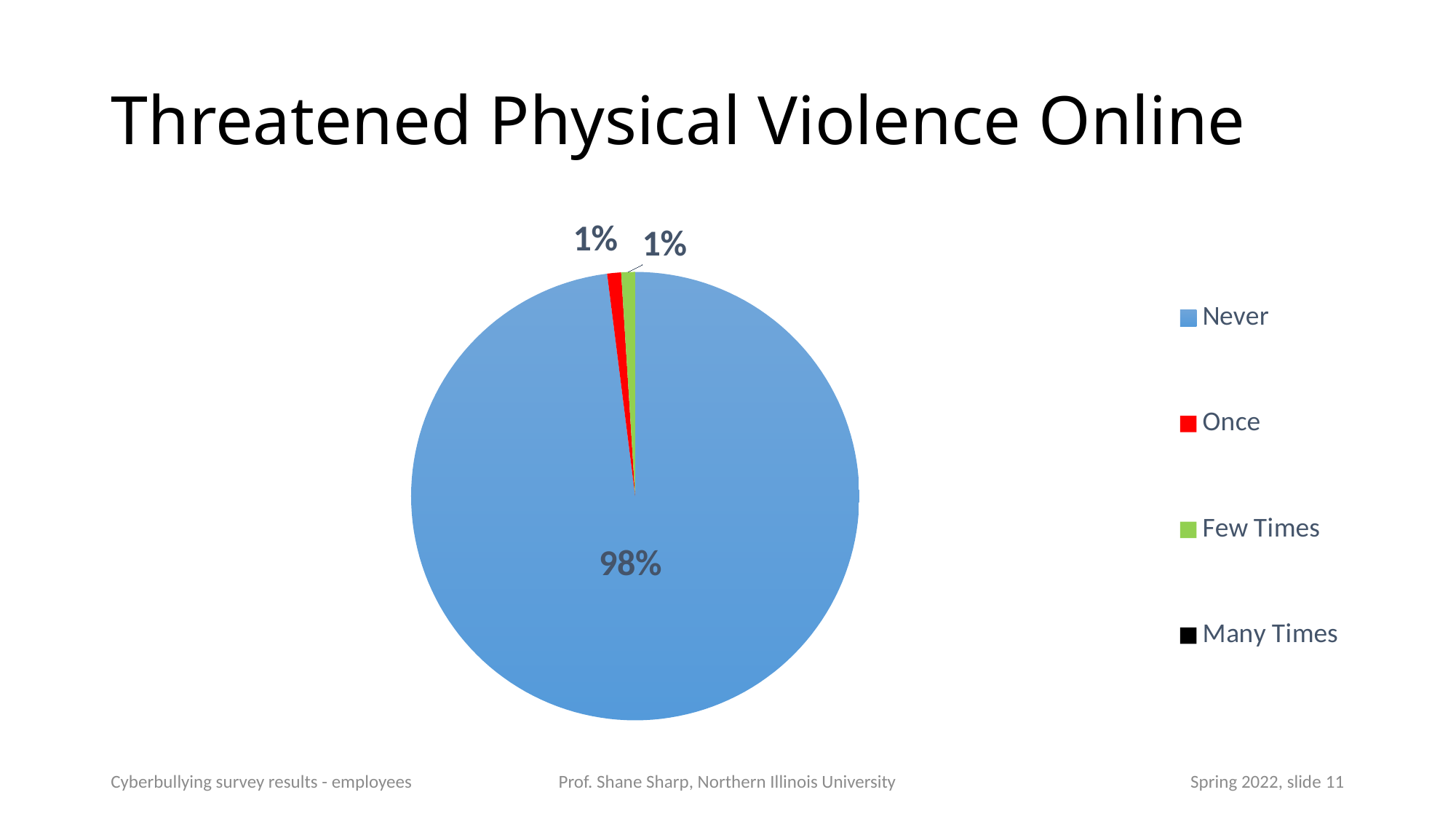
Which is larger, the Never slice or the Few Times slice? Never What is the value shown for the Few Times slice? 1% What colour is used for the Once category in the legend? Red Which category has the largest slice of the pie? Never What is the value shown for the Once slice? 1% What is the difference in percentage points between the Never slice and the Once slice? 97 percentage points How many categories does the legend list? 4 What is the title of the slide? Threatened Physical Violence Online What share of the pie does the Never slice represent? 98% What kind of chart is shown on the slide? Pie chart